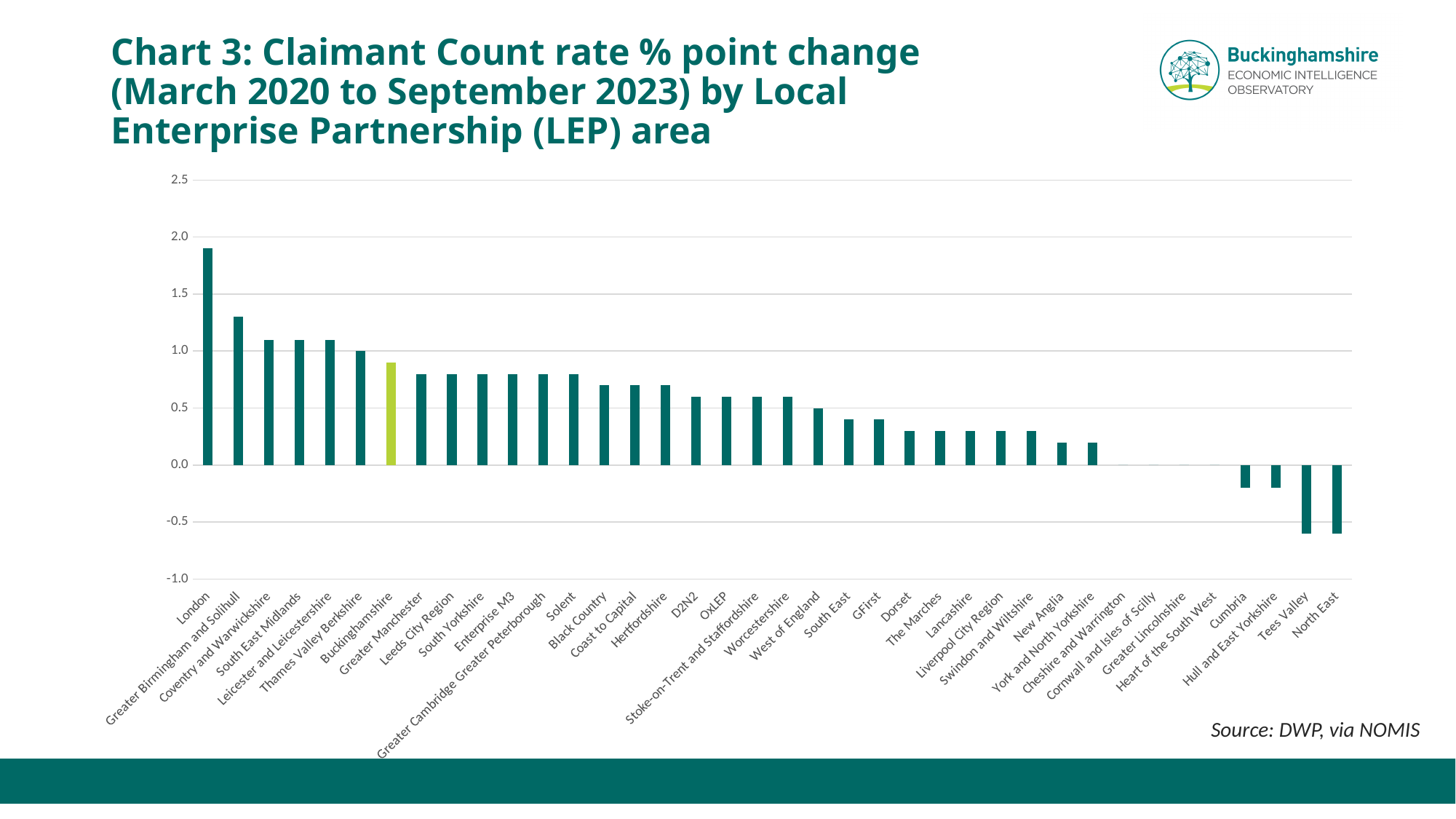
Is the value for Greater Birmingham and Solihull greater or less than 1.0? greater Which LEP area has the highest Claimant Count rate % point change? London Which is larger, the value for Buckinghamshire or the value for Dorset? Buckinghamshire How many LEP areas are shown on the x axis? 38 Is the value for Tees Valley greater or less than -0.5? less Is the value for London greater or less than 1.5? greater Which is larger, the value for London or the value for Greater Birmingham and Solihull? London What is the source cited for the chart? DWP, via NOMIS Which LEP area's bar is highlighted in a different (light green) colour? Buckinghamshire Do the values generally rise or fall moving from left to right along the x axis? Fall What kind of chart is shown on the slide? Bar chart